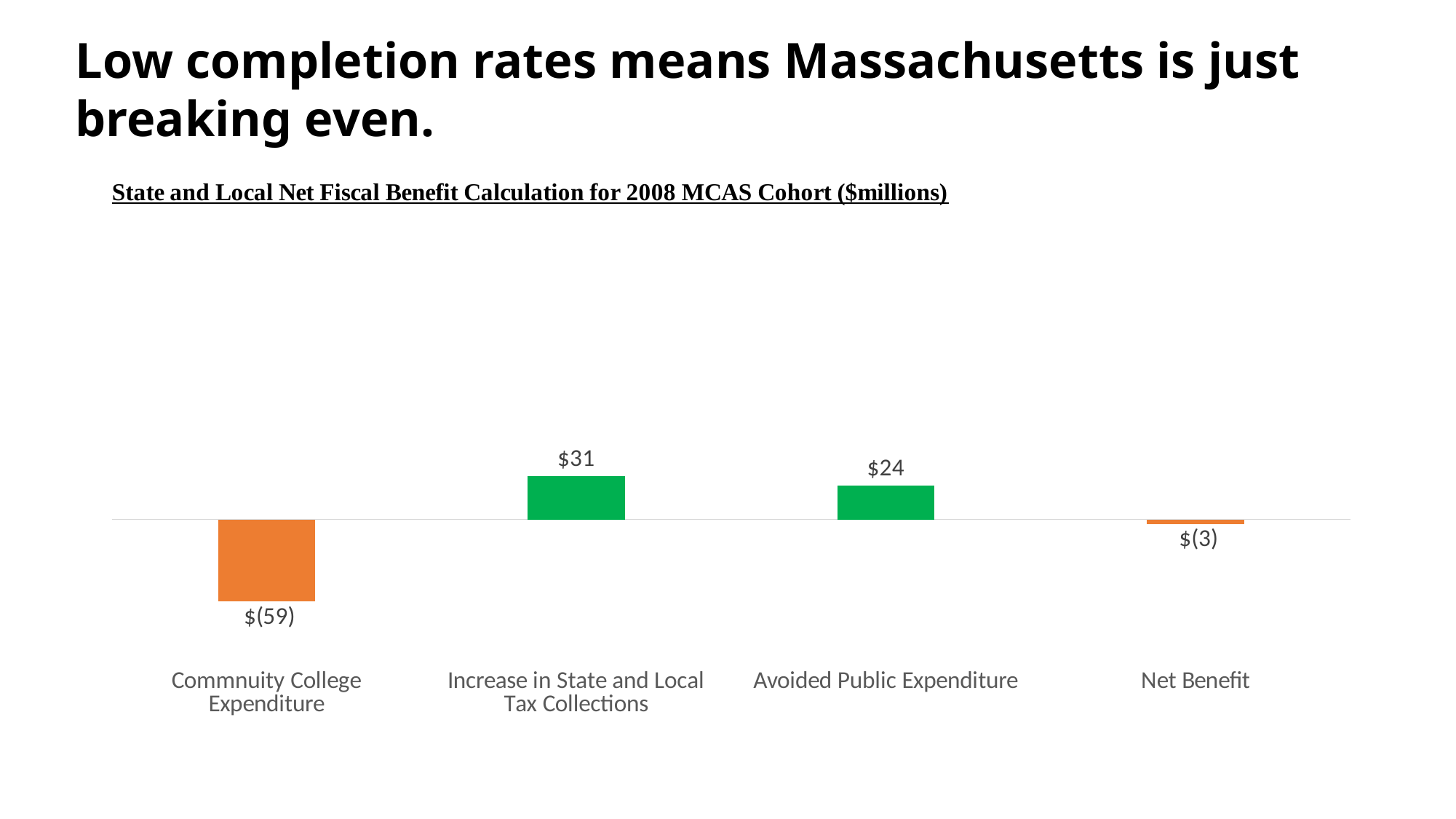
How many categories are shown in the chart? 4 Which category has the highest value? Increase in State and Local Tax Collections What is the value for Avoided Public Expenditure? $24 What colour are the bars with negative values? Orange What is the value for Net Benefit? $(3) Which category has the lowest value? Community College Expenditure What is the value for Increase in State and Local Tax Collections? $31 What is the difference between Increase in State and Local Tax Collections and Avoided Public Expenditure? $7 What kind of chart is shown on the slide? Bar chart What is the value for Community College Expenditure? $(59) Which is larger, Increase in State and Local Tax Collections or Avoided Public Expenditure? Increase in State and Local Tax Collections What is the title of the chart? State and Local Net Fiscal Benefit Calculation for 2008 MCAS Cohort ($millions)